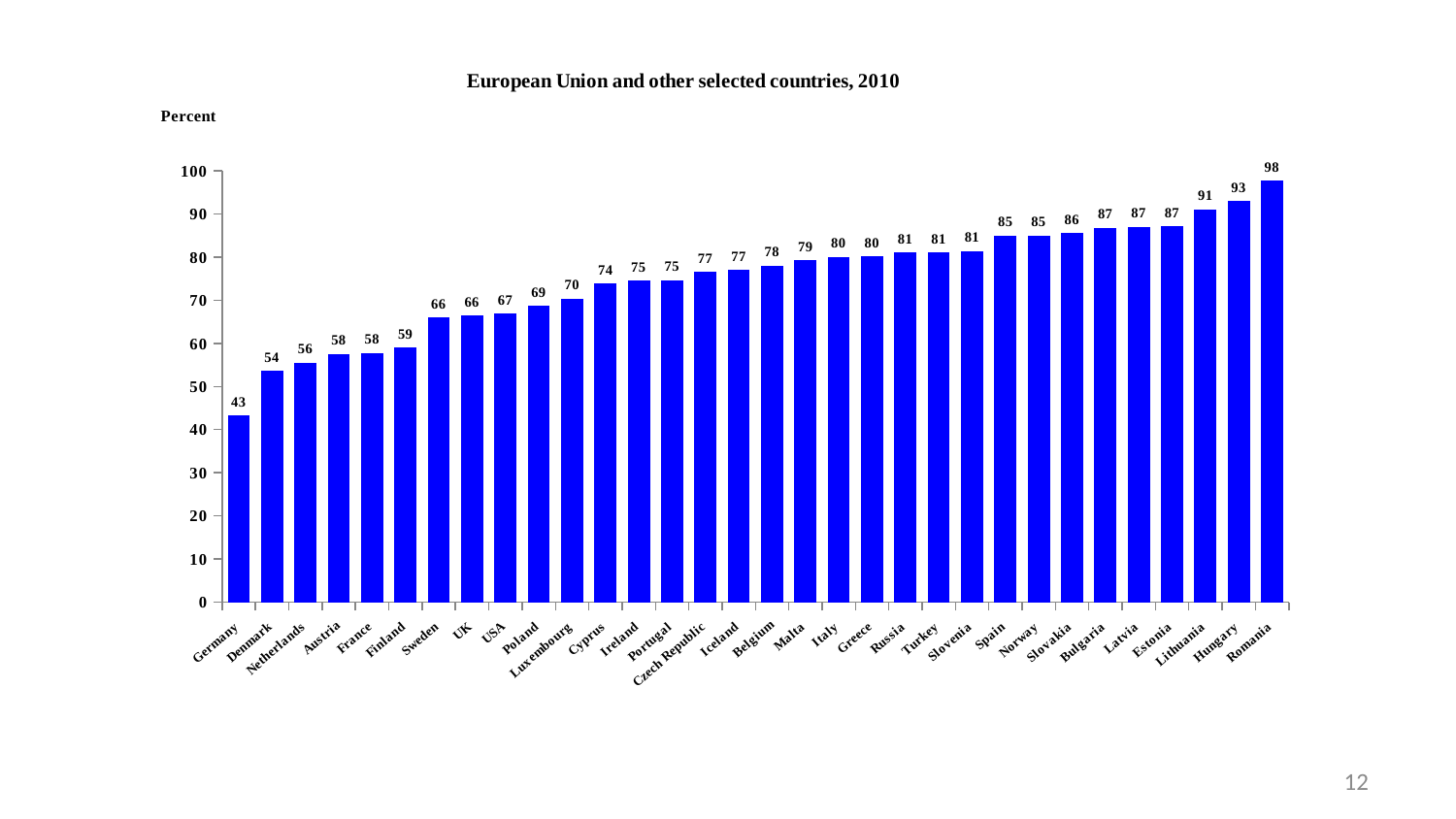
Which has a larger value, Spain or Poland? Spain Do the values rise or fall from left to right along the x axis? Rise Which country has the highest value? Romania What is the value for Germany? 43 What is the difference between the values for Lithuania and Sweden? 25 What is the value for Hungary? 93 What kind of chart is shown on the slide? Bar chart What is the difference between the values for Romania and Germany? 55 What is the value for Luxembourg? 70 Which country has the lowest value? Germany How many countries are shown on the chart? 32 What is the value for Romania? 98